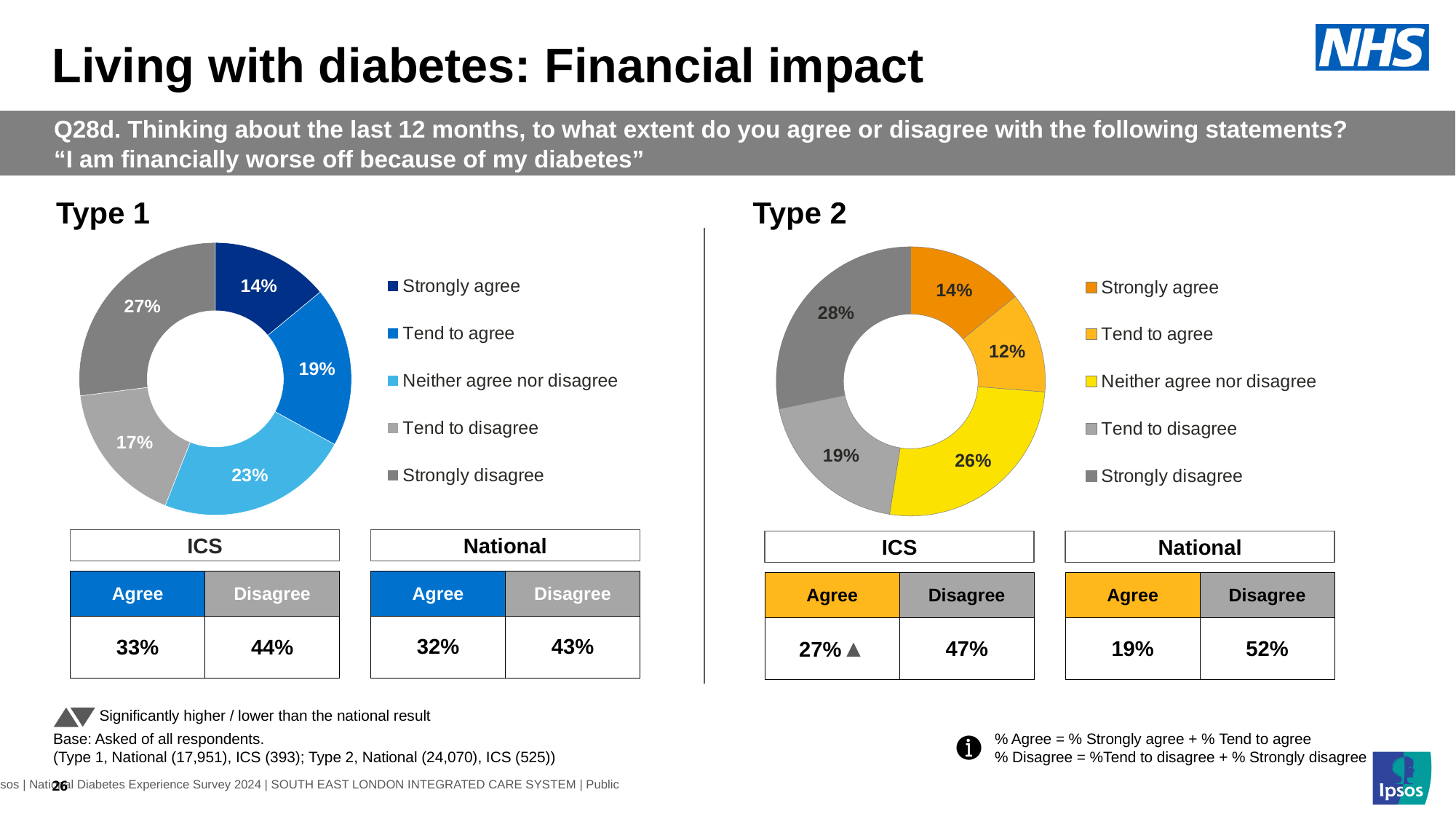
In the Type 2 chart, which response category has the smallest share? Tend to agree In the Type 2 chart, what percentage of respondents said 'Strongly disagree'? 28% In the Type 2 chart, what percentage of respondents said 'Tend to agree'? 12% How many response categories are shown in the Type 2 chart? 5 What type of chart is used for the Type 1 data? Donut (pie) chart In the Type 2 chart, what colour represents 'Neither agree nor disagree'? Yellow In the Type 1 chart, what percentage of respondents said 'Strongly agree'? 14% In the Type 1 chart, which response category has the largest share? Strongly disagree In the Type 1 chart, what is the combined share of 'Strongly agree' and 'Tend to agree'? 33% In the Type 1 chart, what is the difference in percentage points between 'Strongly disagree' and 'Tend to disagree'? 10 percentage points In the Type 1 chart, what percentage of respondents said 'Neither agree nor disagree'? 23% In the Type 2 chart, which is larger: 'Neither agree nor disagree' or 'Tend to disagree'? Neither agree nor disagree